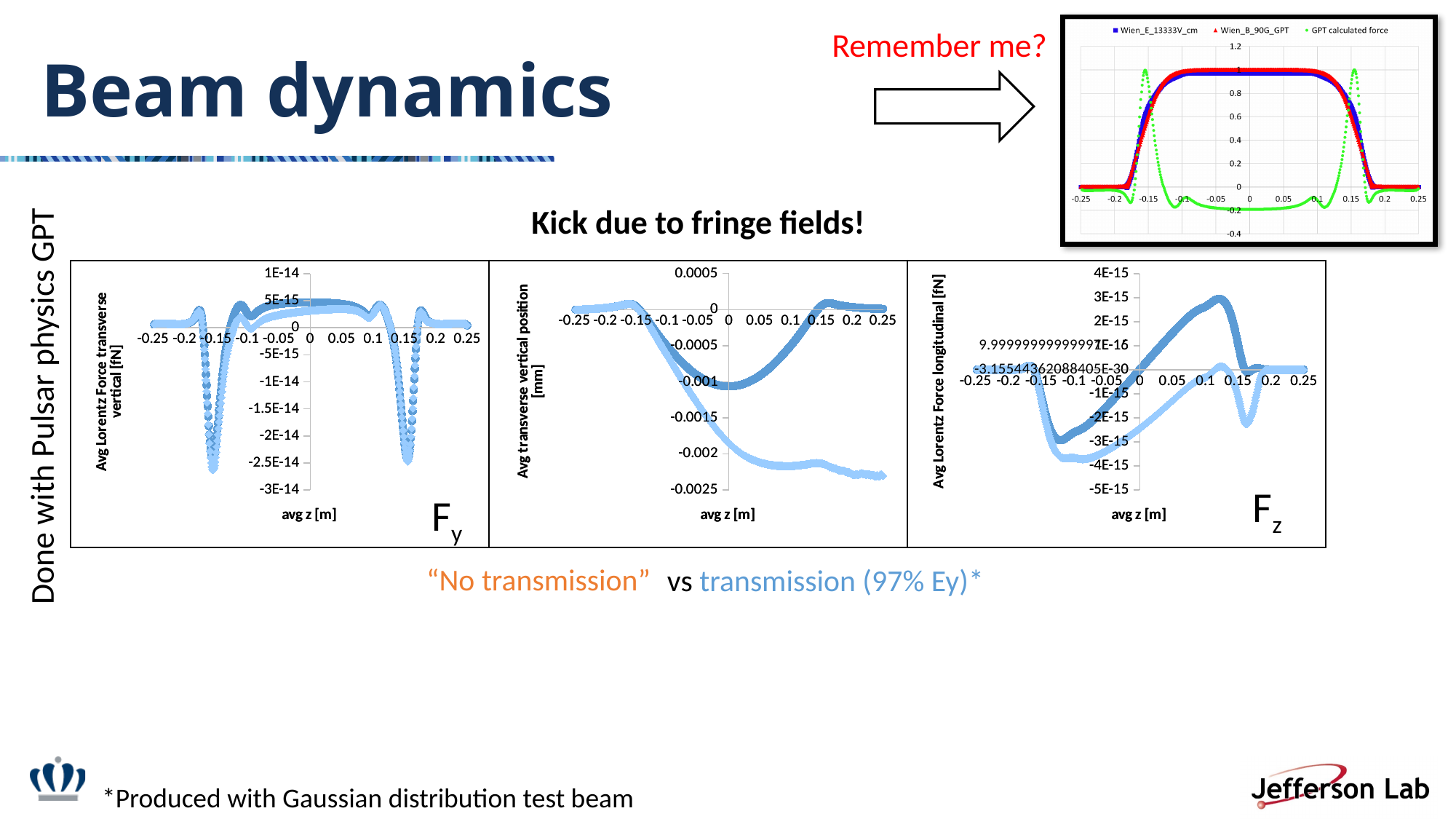
What kind of chart is the bottom-left chart (Fy)? scatter chart In the bottom-middle chart (Avg transverse vertical position), is the light blue series value at avg z = 0.25 greater or less than -0.002? less In the bottom-left chart (Fy), is the value at the dip near avg z = -0.15 greater or less than -2E-14? less In the bottom-right chart (Fz), does the dark blue series rise or fall as avg z goes from -0.15 to 0.1? rise In the bottom-left chart (Fy), is the value at the dip near avg z = 0.15 greater or less than -1E-14? less In the top-right chart, how many series does the legend list? 3 What is the y-axis label of the bottom-left chart (Fy)? Avg Lorentz Force transverse vertical [fN] In the bottom-middle chart (Avg transverse vertical position), does the light blue series rise or fall as avg z goes from -0.15 to 0? fall In the top-right chart, what is the name of the third legend entry? GPT calculated force